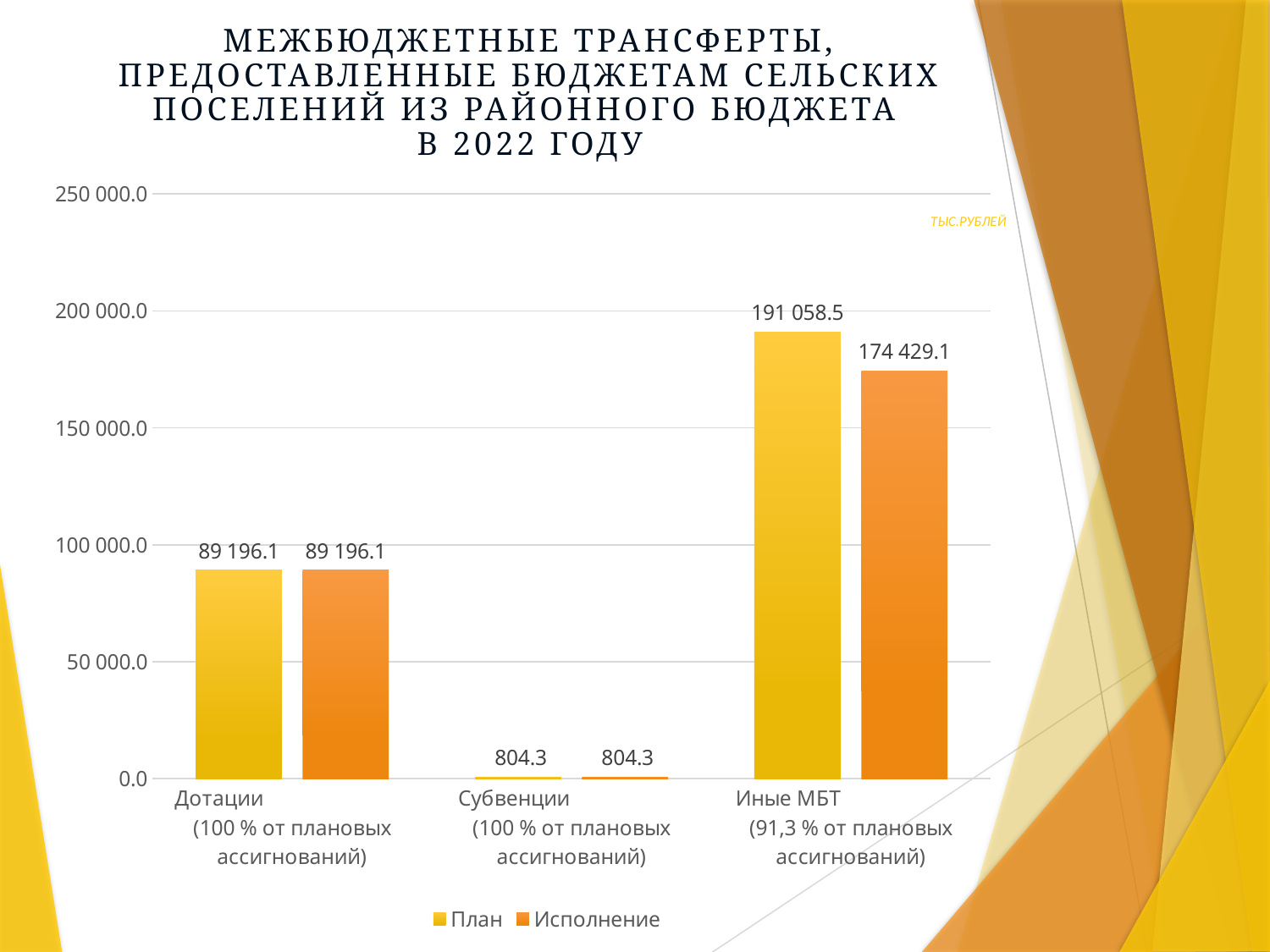
Which is larger for Иные МБТ, the План value or the Исполнение value? План What is the Исполнение value for Иные МБТ? 174 429.1 How many categories are shown on the x axis? 3 What is the План value for Субвенции? 804.3 How many series does the legend list? 2 What unit is indicated in the label at the top right of the chart? ТЫС.РУБЛЕЙ Which category has the lowest Исполнение value? Субвенции Which category has the highest План value? Иные МБТ What is the План value for Дотации? 89 196.1 Is the Исполнение value for Дотации greater or less than 100 000.0? less What kind of chart is shown on the slide? bar chart What is the difference between the План and Исполнение values for Иные МБТ? 16 629.4